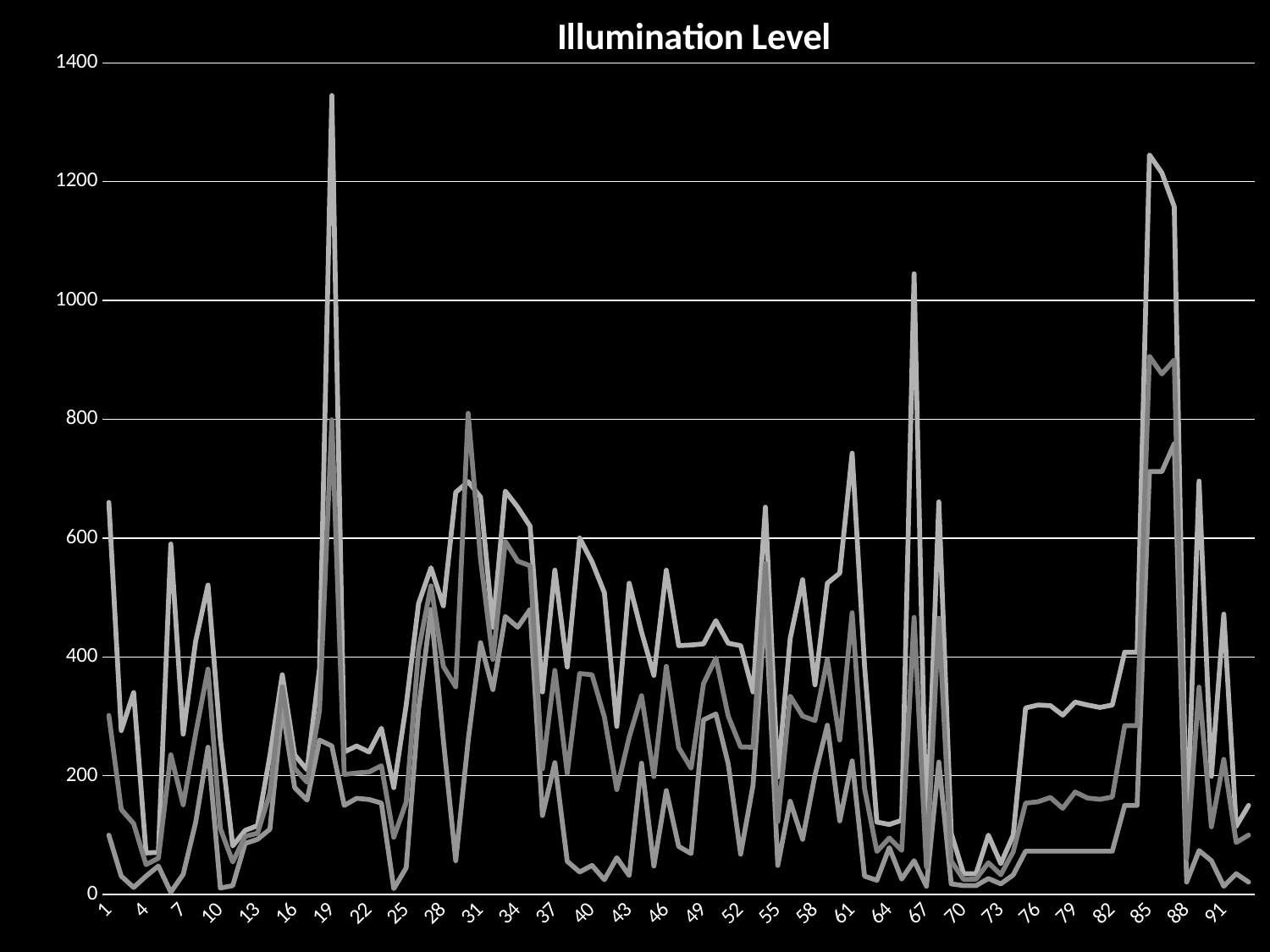
What is the spacing between the labelled gridlines on the y axis? 200 What is the title of the chart? Illumination Level Is the highest peak on the chart greater or less than 1400? less What is the highest value labelled on the y axis? 1400 What kind of chart is shown on the slide? line chart Is the highest peak on the chart greater or less than 1200? greater